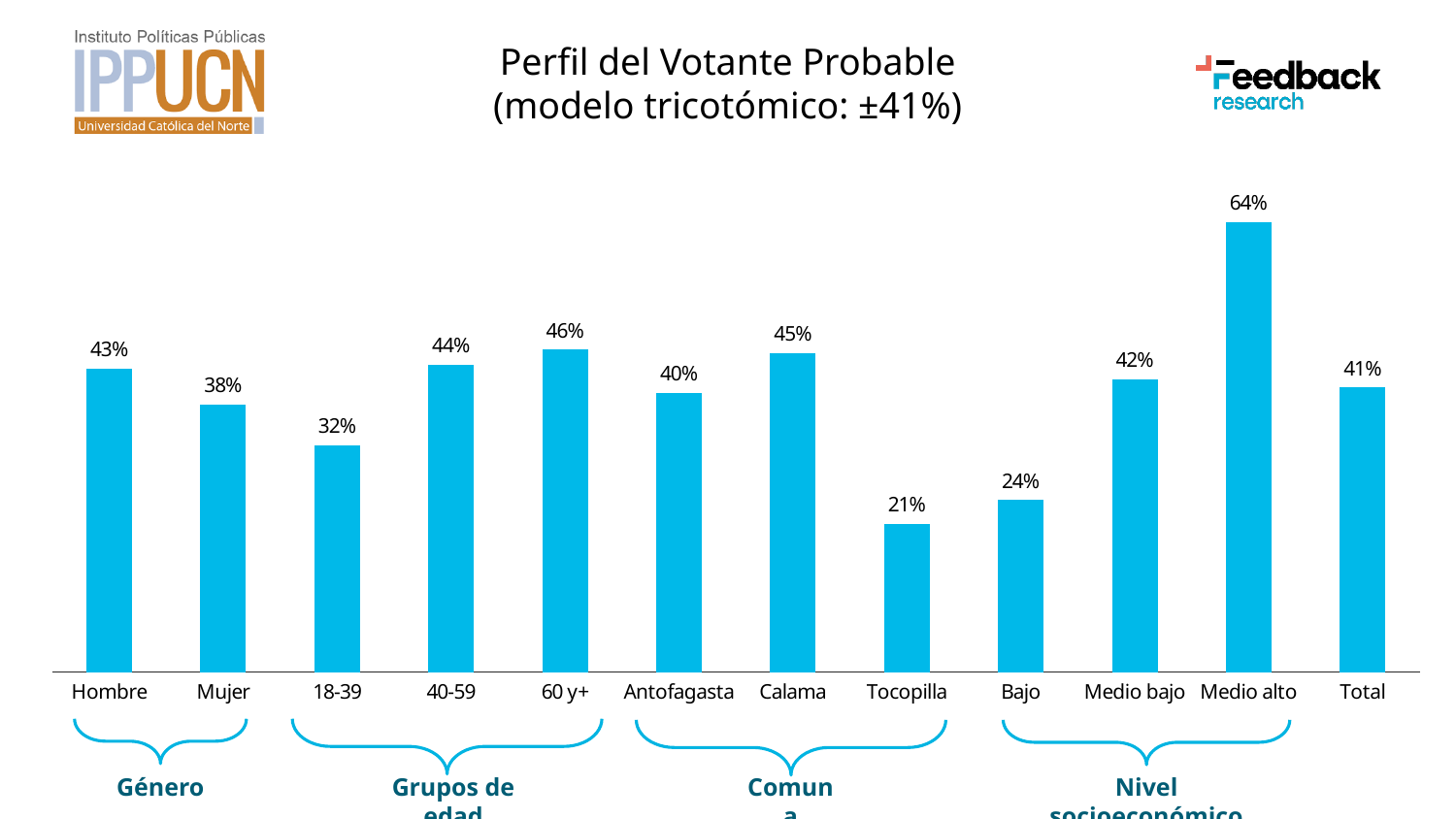
How many bars are plotted on the chart? 12 What is the difference between the values for Hombre and Mujer? 5% What is the difference between the values for Medio alto and Bajo? 40% What is the value for Tocopilla? 21% What is the value for Total? 41% What kind of chart is shown on the slide? Bar chart Do the values rise or fall across the age groups from 18-39 to 60 y+? Rise Which is larger, the value for Calama or the value for Antofagasta? Calama Which category has the lowest value? Tocopilla What is the value for Hombre? 43% Which category has the highest value? Medio alto What is the value for Medio alto? 64%